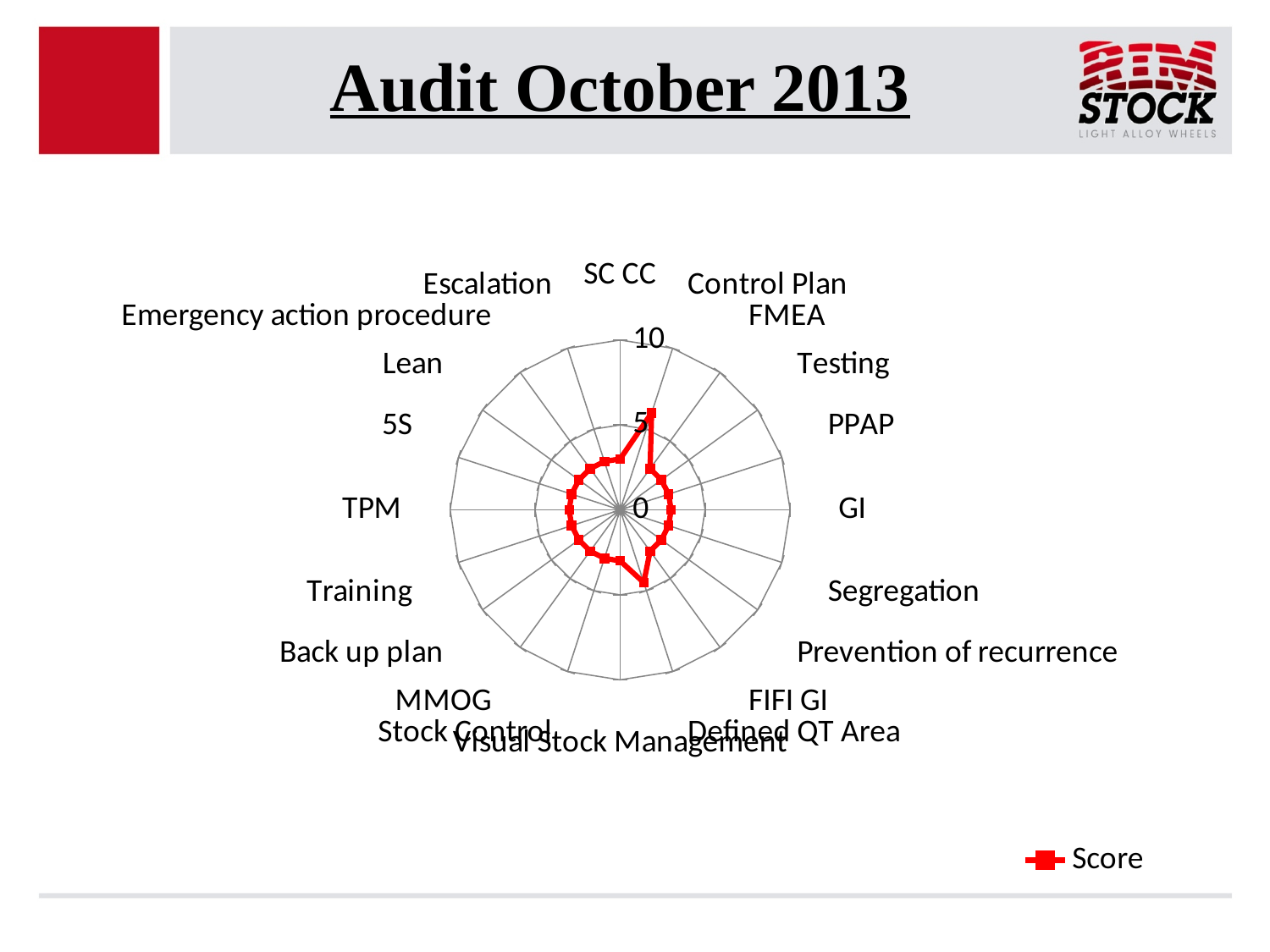
How many categories (axes) does the radar chart have? 20 Is the value for Back up plan greater or less than 5? less Is the value for PPAP greater or less than 5? less Is the value for Segregation greater or less than 5? less What is the maximum value shown on the chart's radial axis? 10 What kind of chart is shown on the slide? Radar chart How many series does the legend list? 1 What is the name of the series shown in the legend? Score